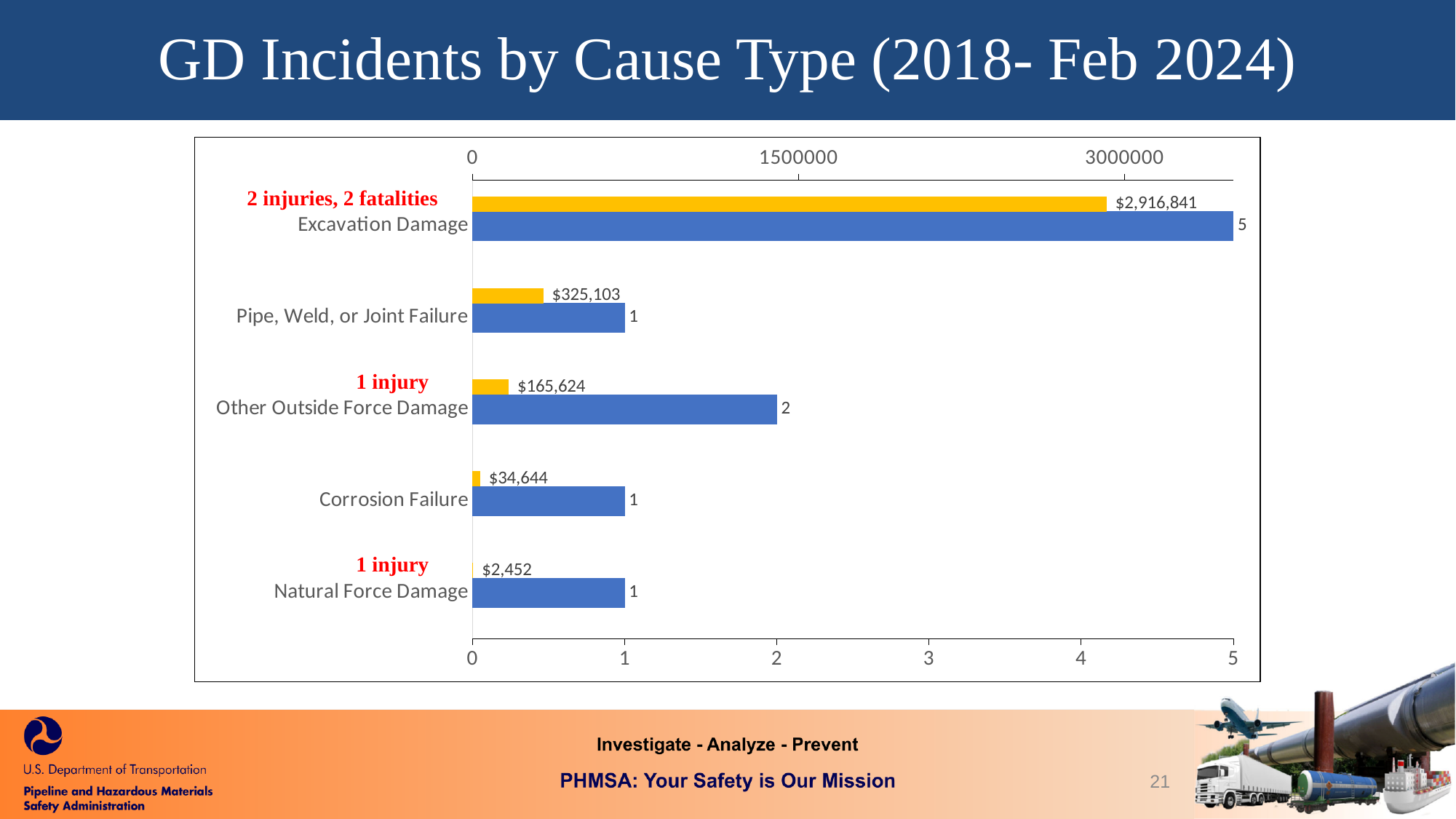
What is the dollar value (yellow bar) for Corrosion Failure? $34,644 What is the number of incidents (blue bar) for Other Outside Force Damage? 2 Is the dollar value (yellow bar) for Excavation Damage greater or less than 1500000? greater Which cause type has the highest dollar value (yellow bar)? Excavation Damage What kind of chart is shown on the slide? bar chart How many cause-type categories are shown in the chart? 5 What is the dollar value (yellow bar) for Pipe, Weld, or Joint Failure? $325,103 What is the difference in incident count (blue bars) between Excavation Damage and Other Outside Force Damage? 3 Which has a larger dollar value (yellow bar): Other Outside Force Damage or Corrosion Failure? Other Outside Force Damage Which cause type has the lowest dollar value (yellow bar)? Natural Force Damage What is the number of incidents (blue bar) for Excavation Damage? 5 What red annotation is shown next to the Excavation Damage category? 2 injuries, 2 fatalities